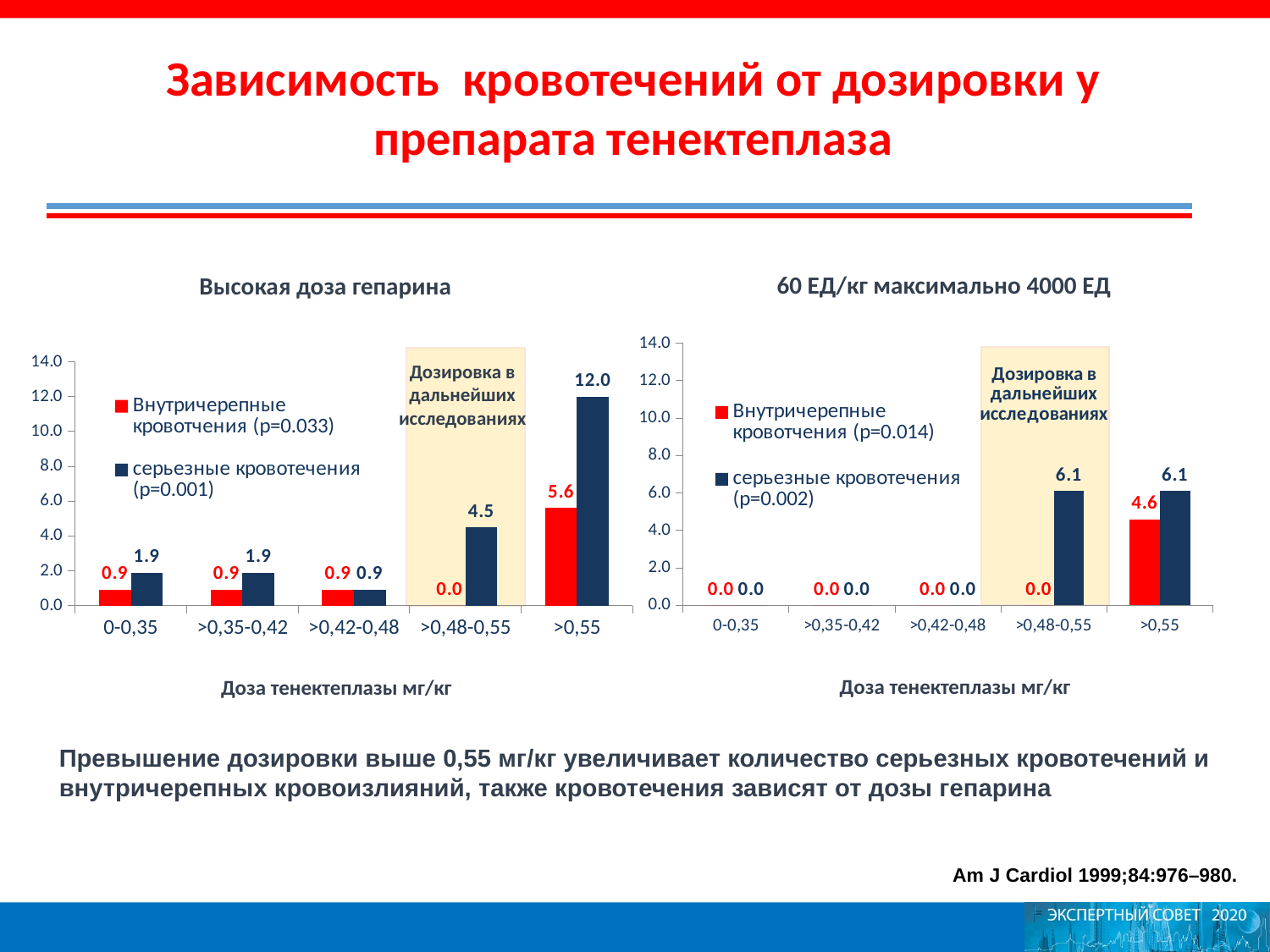
In the chart titled "60 ЕД/кг максимально 4000 ЕД", what is the value of серьезные кровотечения for the dose >0,48-0,55? 6.1 In the chart titled "Высокая доза гепарина", what is the value of серьезные кровотечения for the dose >0,48-0,55? 4.5 In the chart titled "Высокая доза гепарина", what is the difference between серьезные кровотечения and Внутричерепные кровотчения for the dose >0,55? 6.4 In the chart titled "60 ЕД/кг максимально 4000 ЕД", how many series does the legend list? 2 In the chart titled "Высокая доза гепарина", which dose category has the highest value of серьезные кровотечения? >0,55 Which is larger: серьезные кровотечения for >0,55 in the chart titled "Высокая доза гепарина" or серьезные кровотечения for >0,55 in the chart titled "60 ЕД/кг максимально 4000 ЕД"? Высокая доза гепарина In the chart titled "60 ЕД/кг максимально 4000 ЕД", how many dose categories are shown on the x axis? 5 In the chart titled "Высокая доза гепарина", what is the p-value shown in the legend for серьезные кровотечения? p=0.001 In the chart titled "Высокая доза гепарина", what is the value of Внутричерепные кровотчения for the dose >0,55? 5.6 In the chart titled "60 ЕД/кг максимально 4000 ЕД", what is the value of Внутричерепные кровотчения for the dose >0,55? 4.6 In the chart titled "Высокая доза гепарина", what is the value of серьезные кровотечения for the dose >0,55? 12.0 What kind of chart is the chart titled "Высокая доза гепарина"? Bar chart